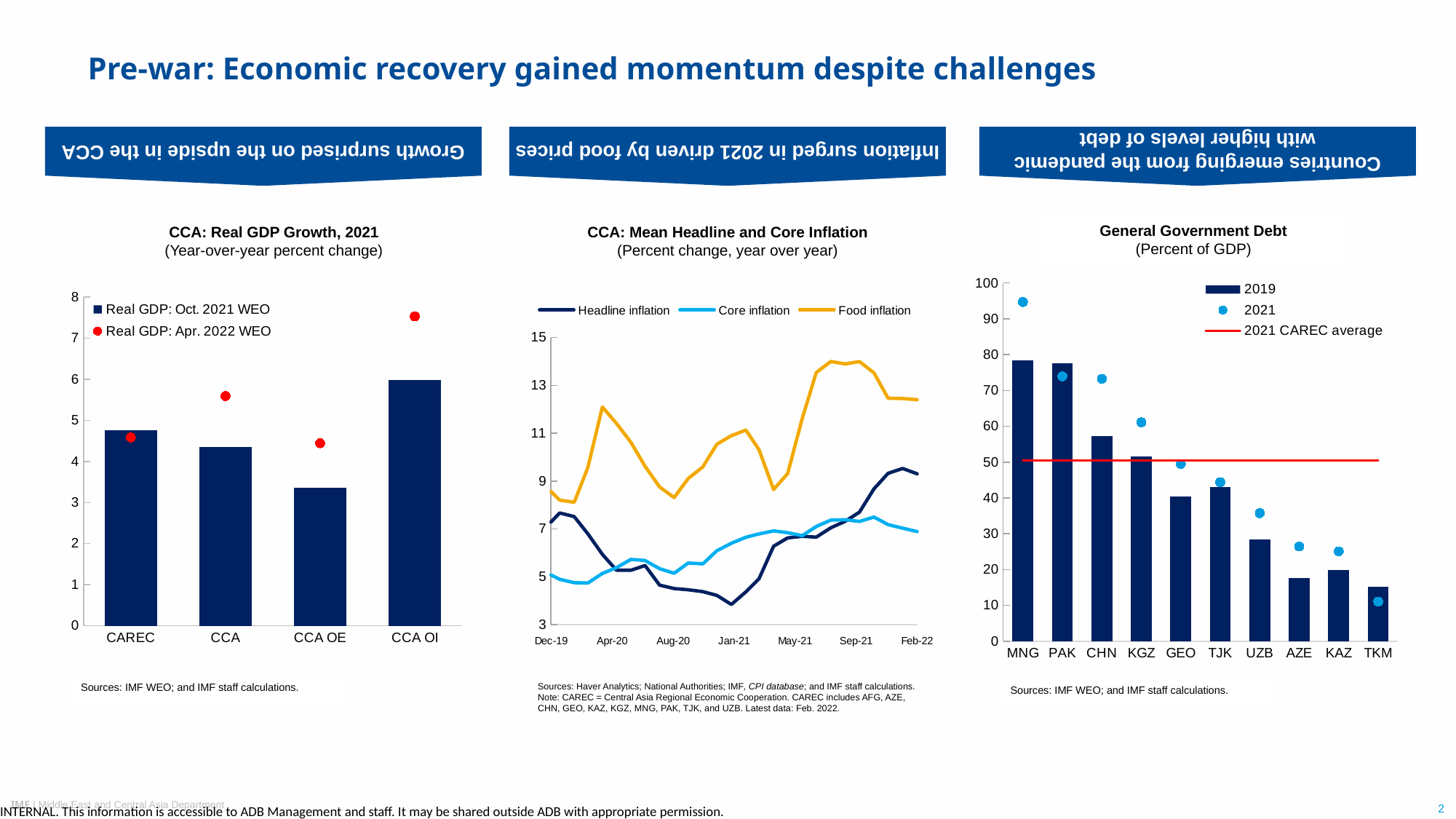
In the 'CCA: Real GDP Growth, 2021' chart, how many categories are shown on the x axis? 4 In the 'General Government Debt' chart, is the 2019 value for CHN greater or less than 50? greater In the 'CCA: Real GDP Growth, 2021' chart, how many series does the legend list? 2 In the 'CCA: Mean Headline and Core Inflation' chart, which series has the highest value at Feb-22? Food inflation In the 'CCA: Real GDP Growth, 2021' chart, is the Real GDP: Apr. 2022 WEO value for CCA OI greater or less than 7? greater In the 'CCA: Real GDP Growth, 2021' chart, which category has the lowest Real GDP: Oct. 2021 WEO bar? CCA OE In the 'General Government Debt' chart, which country has the highest 2021 value? MNG In the 'General Government Debt' chart, how many countries are shown on the x axis? 10 What kind of chart is 'CCA: Mean Headline and Core Inflation'? line chart In the 'CCA: Mean Headline and Core Inflation' chart, how many series does the legend list? 3 In the 'CCA: Mean Headline and Core Inflation' chart, does headline inflation rise or fall between Jan-21 and Feb-22? rise In the 'CCA: Real GDP Growth, 2021' chart, which category has the highest Real GDP: Oct. 2021 WEO bar? CCA OI